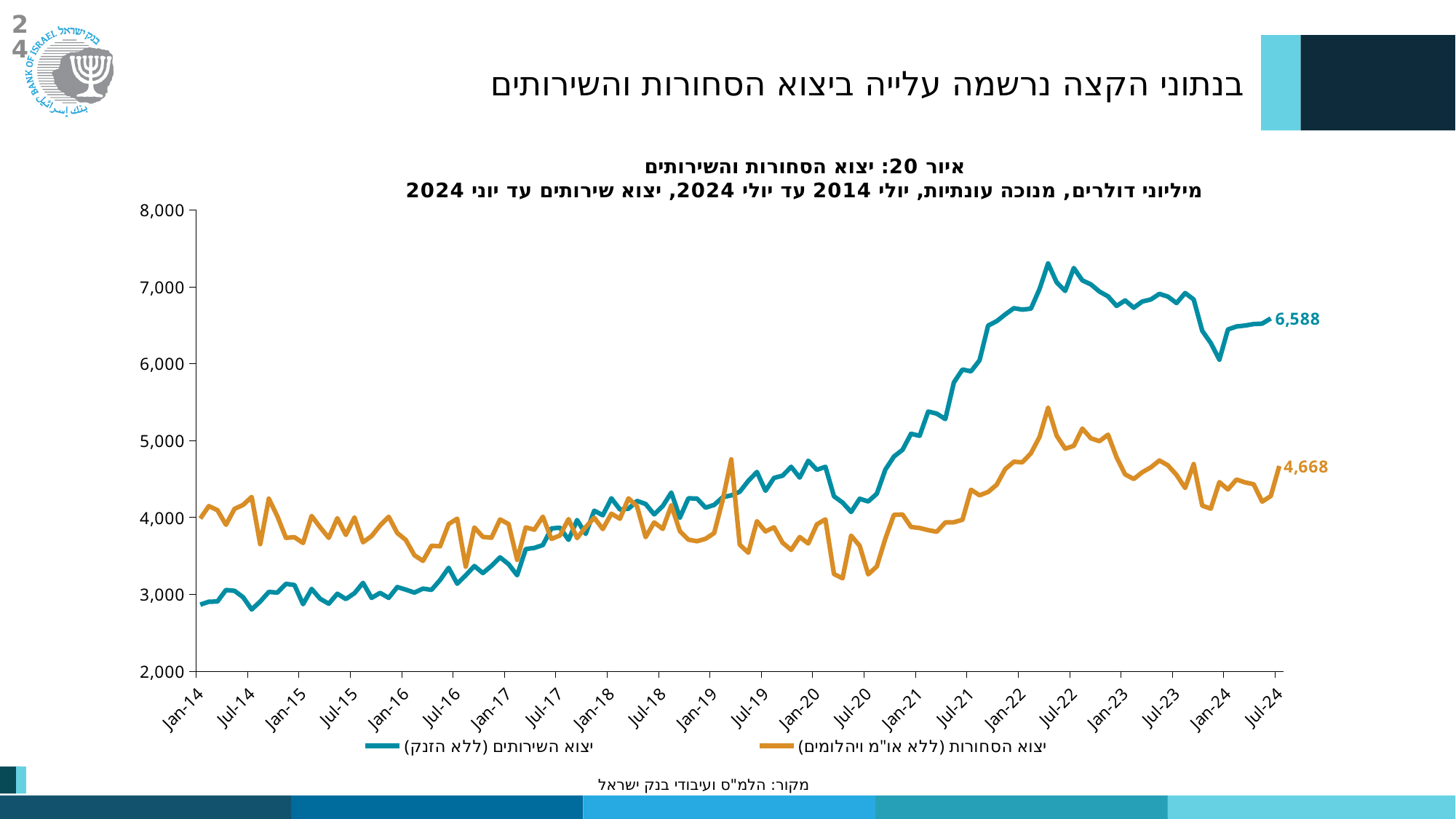
What kind of chart is shown on the slide? Line chart Is the value of the services exports series at Jan-22 greater or less than 6,000? greater Which series reaches the highest value anywhere on the chart? Services exports (יצוא השירותים) Is the value of the goods exports series around Jul-20 greater or less than 4,000? less Does the services exports series generally rise or fall from Jan-14 to Jul-24? Rise At the end of the chart, which series has the higher value: services exports or goods exports? Services exports (יצוא השירותים) What is the labelled value of the services exports series (יצוא השירותים) at the end of the chart? 6,588 How many series does the legend list? 2 What is the labelled value of the goods exports series (יצוא הסחורות) at the end of the chart? 4,668 Is the value of the services exports series around Jul-22 greater or less than 7,000? greater What is the figure number given in the chart title? איור 20 What is the difference between the final labelled values of services exports (6,588) and goods exports (4,668)? 1,920